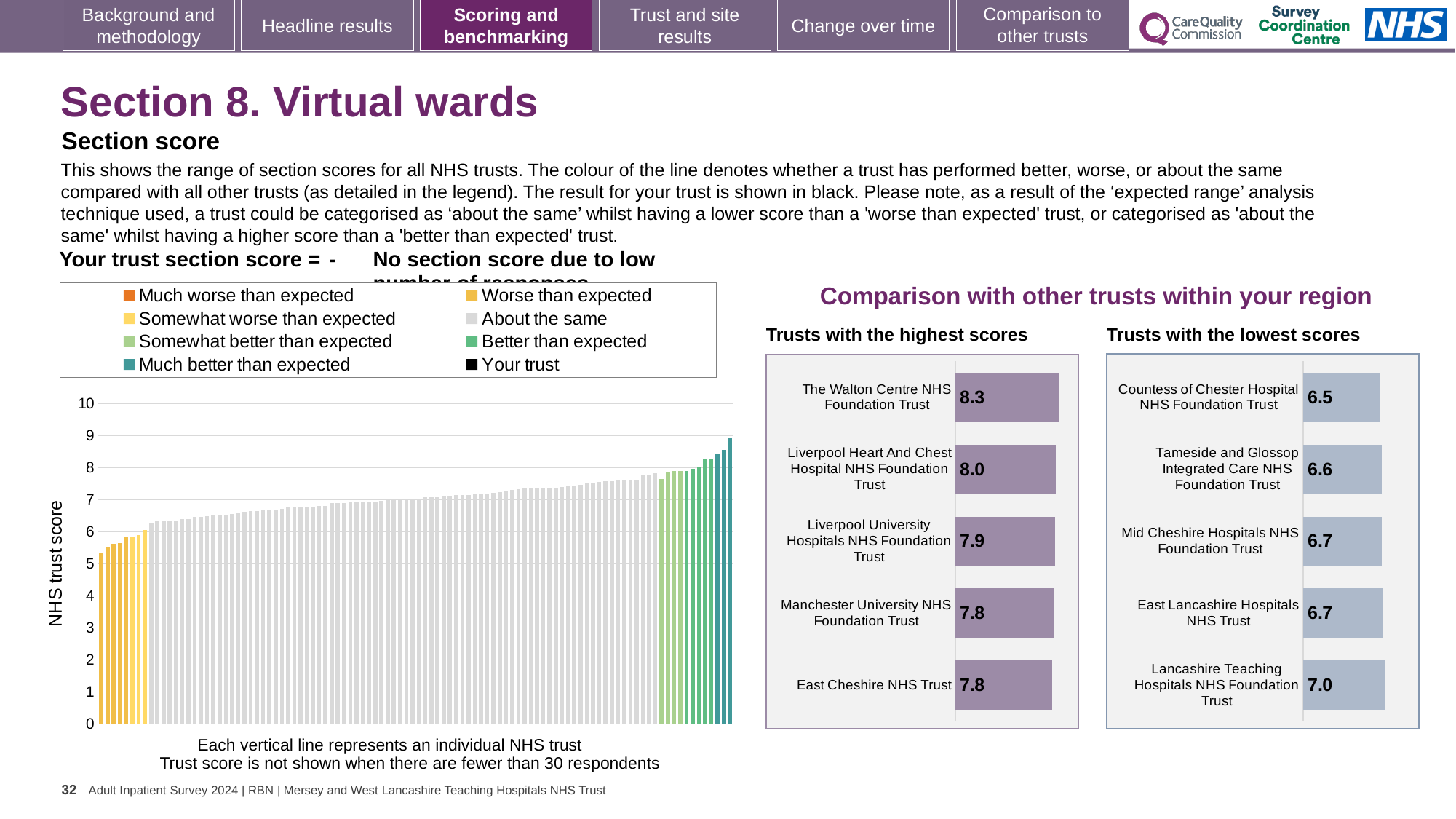
In the 'Trusts with the highest scores' chart, which trust has the highest score? The Walton Centre NHS Foundation Trust In the 'Trusts with the lowest scores' chart, which trust has the lowest score? Countess of Chester Hospital NHS Foundation Trust In the 'Trusts with the lowest scores' chart, which has the larger score: Tameside and Glossop Integrated Care NHS Foundation Trust or Lancashire Teaching Hospitals NHS Foundation Trust? Lancashire Teaching Hospitals NHS Foundation Trust In the large chart on the left, is the value of the tallest bar greater or less than 8? greater In the 'Trusts with the lowest scores' chart, what is the score for Lancashire Teaching Hospitals NHS Foundation Trust? 7.0 In the 'Trusts with the highest scores' chart, what is the score for The Walton Centre NHS Foundation Trust? 8.3 In the large chart on the left, do the NHS trust scores rise or fall from left to right? Rise In the 'Trusts with the lowest scores' chart, what is the score for Mid Cheshire Hospitals NHS Foundation Trust? 6.7 How many entries does the legend of the large chart on the left list? 8 What kind of chart is the large chart on the left showing NHS trust scores? Bar chart How many trusts are shown in the 'Trusts with the highest scores' chart? 5 In the 'Trusts with the highest scores' chart, what is the difference between the scores of The Walton Centre NHS Foundation Trust and East Cheshire NHS Trust? 0.5